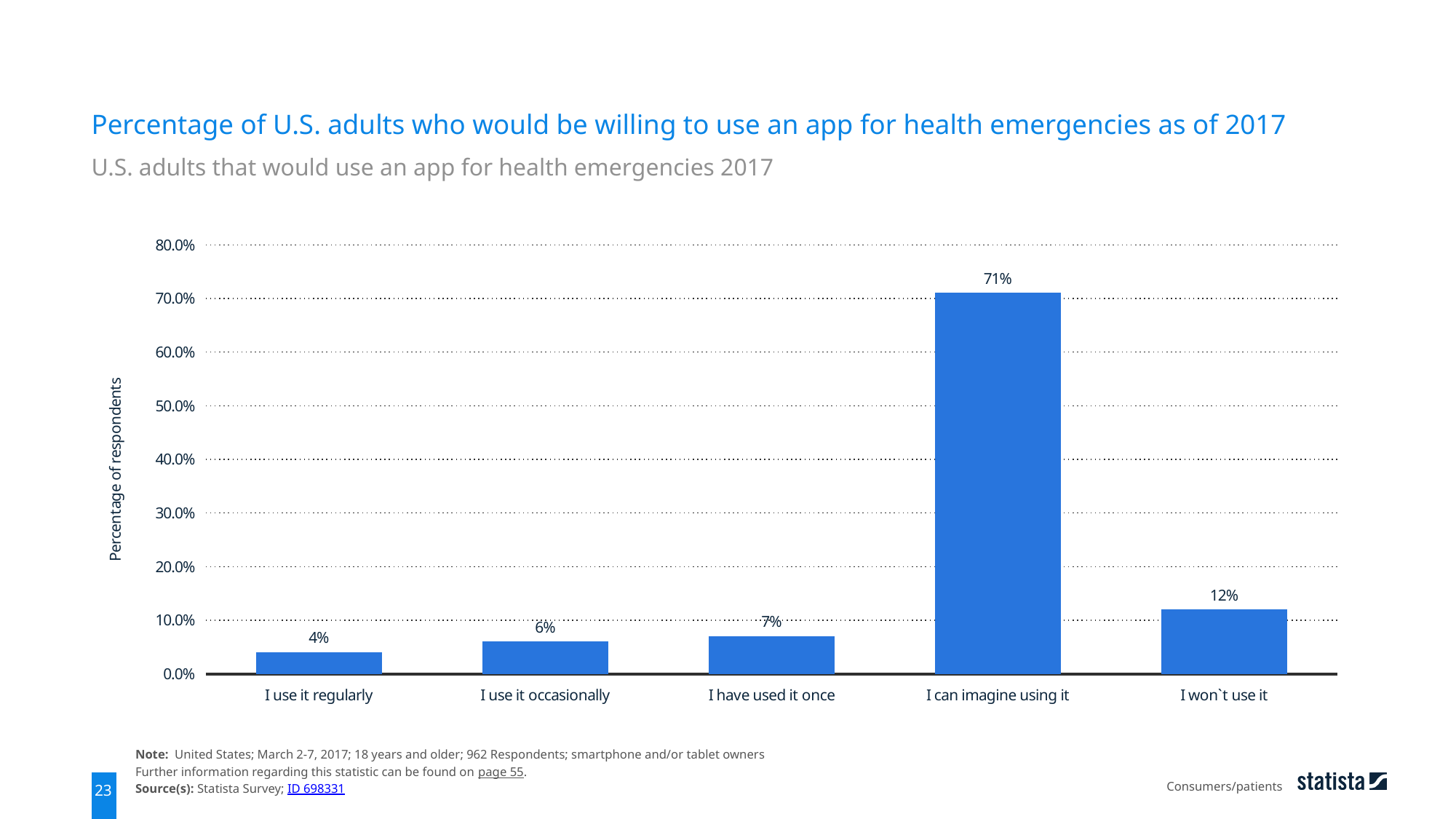
Which is larger: the value for "I use it occasionally" or the value for "I won`t use it"? I won`t use it Is the value for "I can imagine using it" greater or less than 70.0%? greater Which response category has the highest percentage of respondents? I can imagine using it What is the difference in percentage points between "I can imagine using it" and "I won`t use it"? 59 What percentage of respondents said "I won`t use it"? 12% How many response categories are shown on the x axis? 5 What kind of chart is shown on the slide? Bar chart What percentage of respondents said "I have used it once"? 7% Which response category has the lowest percentage of respondents? I use it regularly What is the label of the vertical axis? Percentage of respondents What percentage of respondents said "I use it regularly"? 4% What percentage of respondents said "I can imagine using it"? 71%